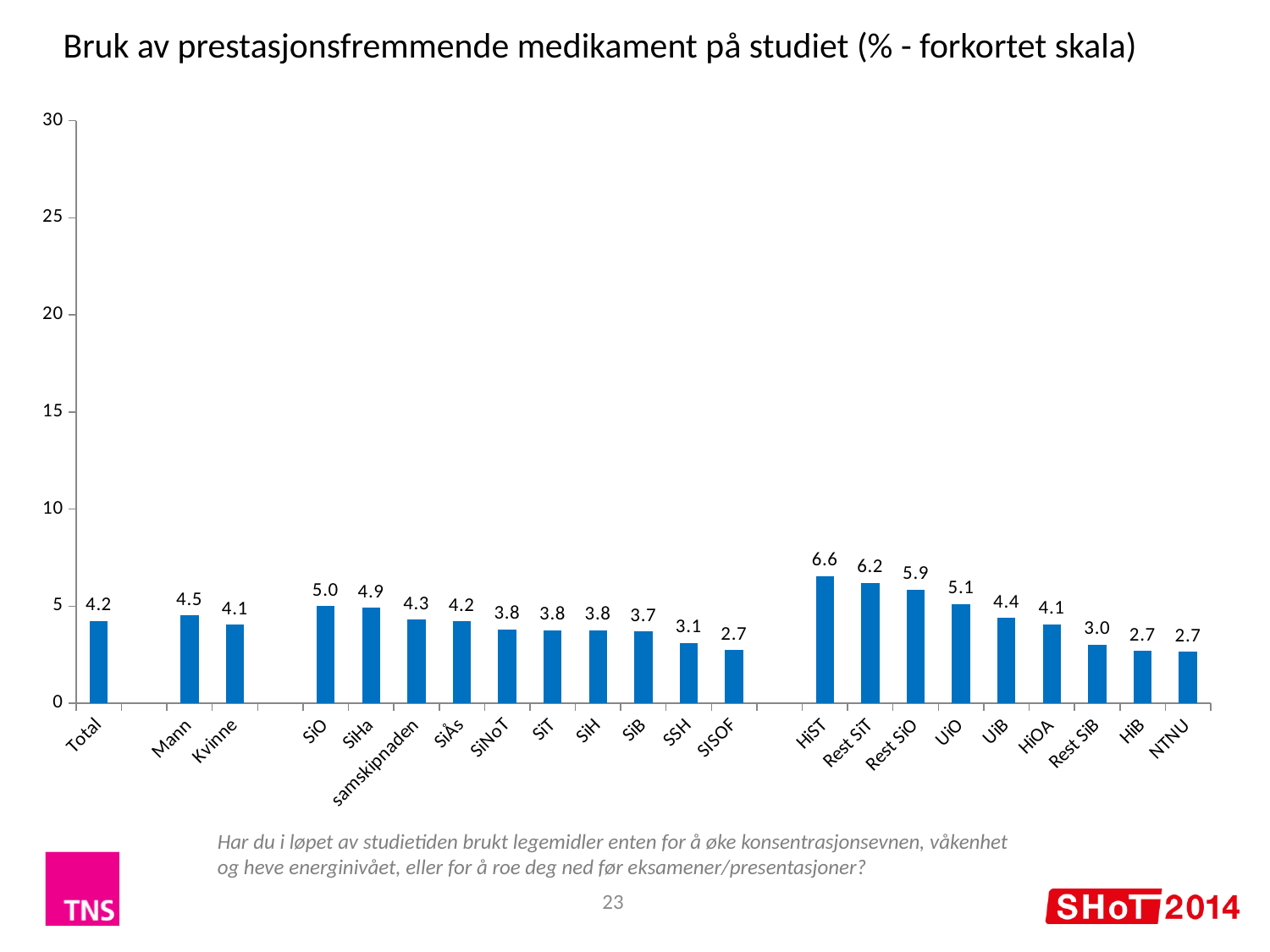
What kind of chart is shown on the slide? Bar chart Which category has the highest value? HiST What is the difference between the values for HiST and NTNU? 3.9 What is the value for SiO? 5.0 Is the value for Rest SiT greater or less than 5? greater How many categories are shown on the x axis? 22 What is the difference between the values for Mann and Kvinne? 0.4 Which is larger, the value for SSH or the value for SiHa? SiHa What is the value for Total? 4.2 What is the value for Rest SiB? 3.0 Which is larger, the value for UiO or the value for UiB? UiO What is the value for HiST? 6.6